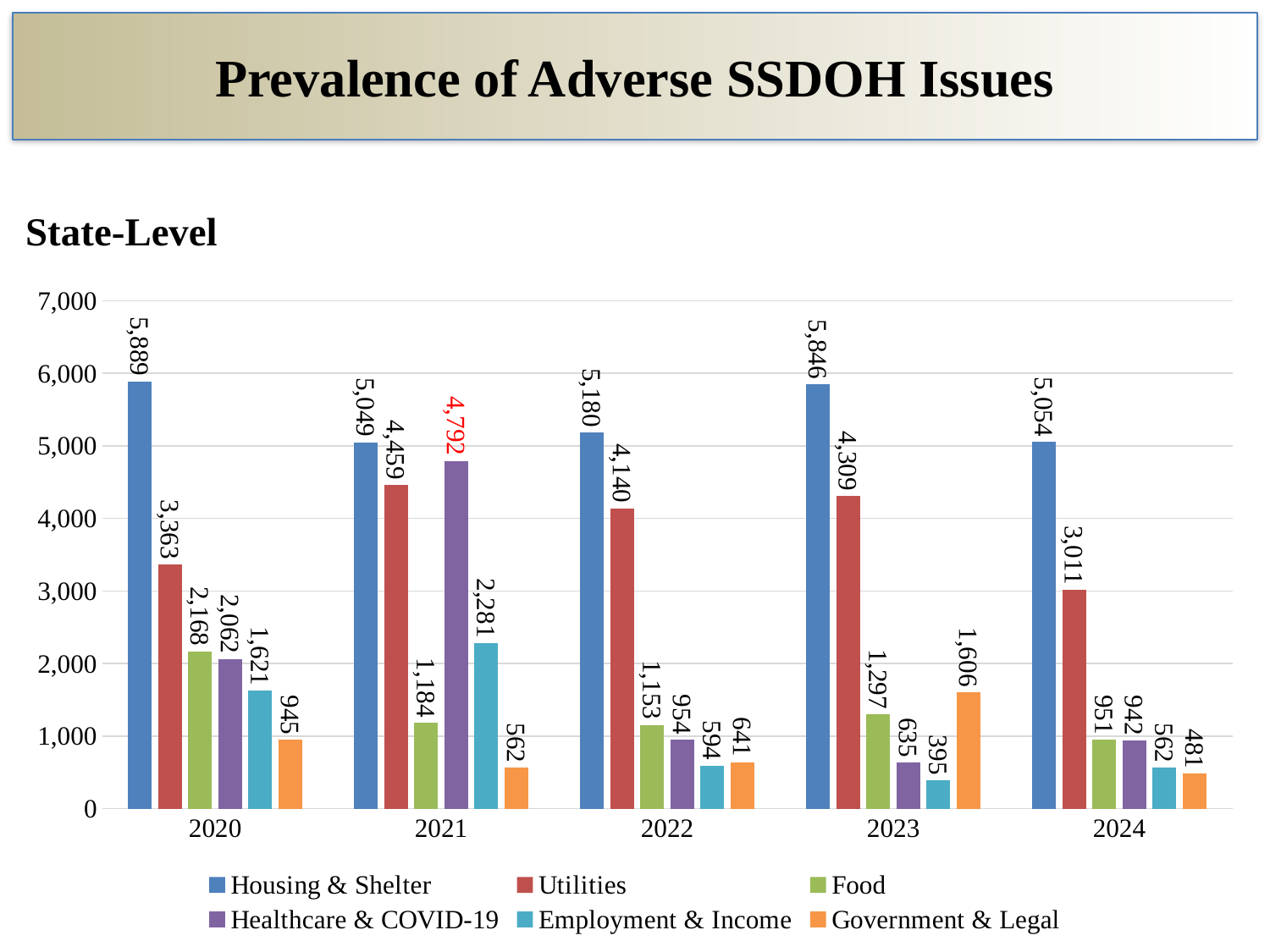
What is the value for Government & Legal in 2023? 1,606 What is the value for Housing & Shelter in 2020? 5,889 How many years are shown on the x axis? 5 In which year is the Employment & Income value lowest? 2023 What is the difference between the Housing & Shelter values in 2020 and 2024? 835 In which year is the Utilities value highest? 2021 What type of chart is shown on the slide? Bar chart Does the Utilities value rise or fall from 2021 to 2024? Fall What is the value for Healthcare & COVID-19 in 2021? 4,792 How many series does the legend list? 6 Which is larger in 2022: Food or Healthcare & COVID-19? Food Which data label is printed in red on the chart? 4,792